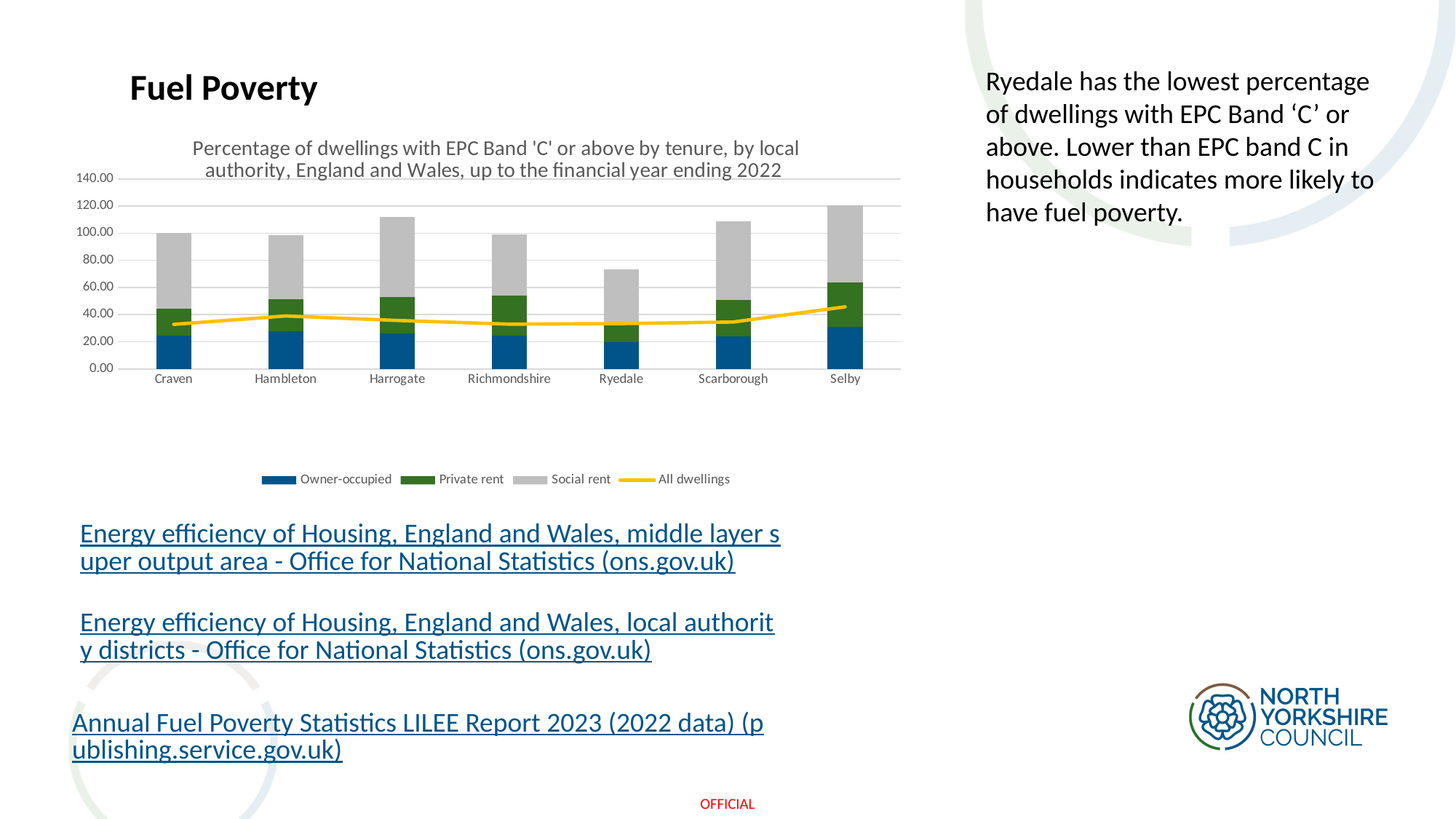
Which series is plotted as a line rather than as bars? All dwellings Which has the larger total stacked bar, Ryedale or Scarborough? Scarborough Which local authority has the highest All dwellings line value? Selby Which local authority has the highest total stacked bar? Selby How many series does the chart legend list? 4 How many local authorities are shown on the x axis of the chart? 7 Is the total stacked bar for Ryedale greater or less than 80? less Is the All dwellings value for Selby greater or less than 40? greater Is the total stacked bar for Harrogate greater or less than 100? greater What kind of chart is shown on the slide? combination bar and line chart (stacked bars with a line) What colour represents Social rent in the chart? grey Which local authority has the lowest total stacked bar? Ryedale